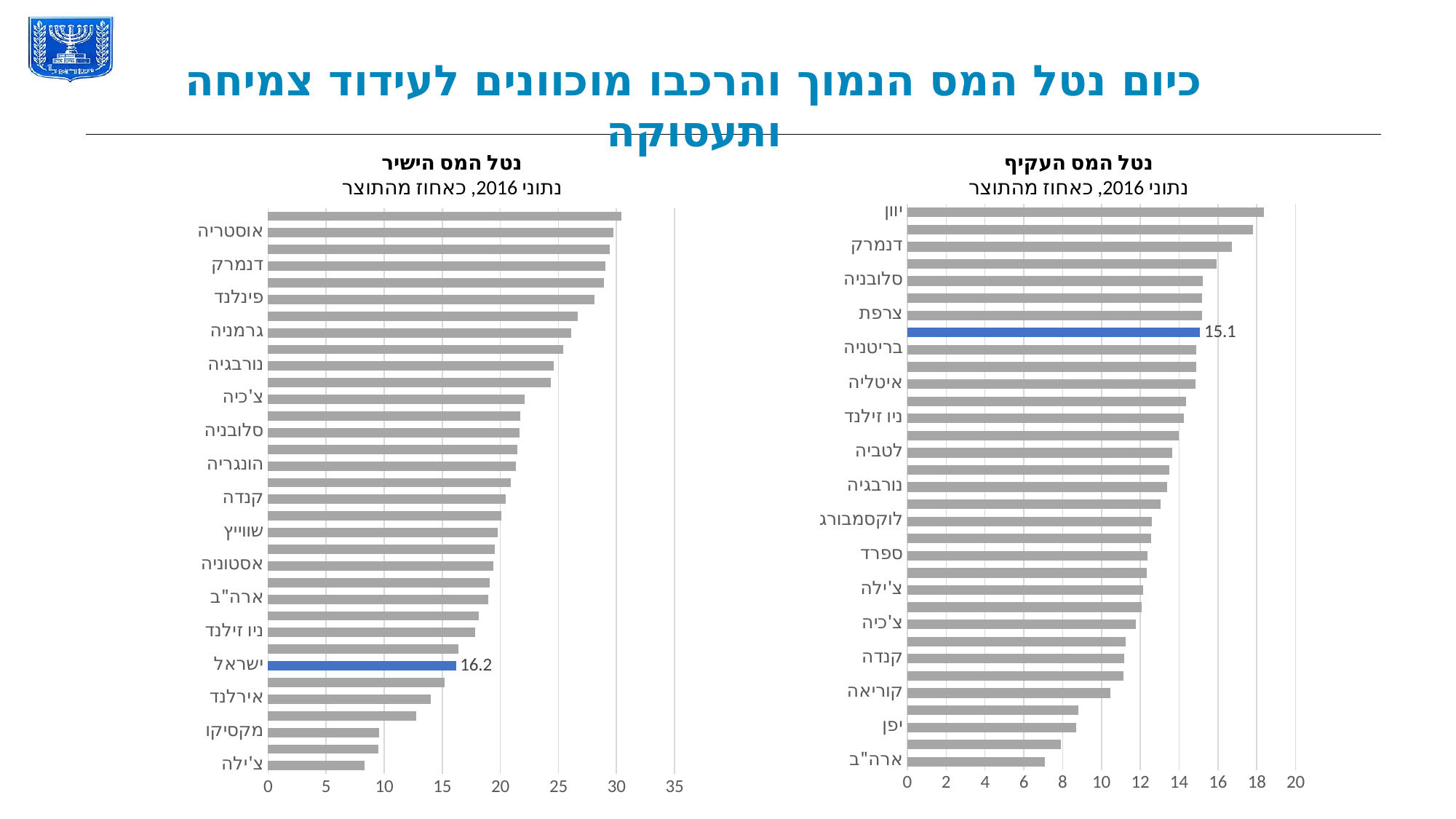
In the left chart (נטל המס הישיר), which country's bar is highlighted in blue? ישראל In the right chart (נטל המס העקיף), which has a larger value, יוון or יפן? יוון In the left chart (נטל המס הישיר), what is the value shown for ישראל? 16.2 In the right chart (נטל המס העקיף), what value is printed on the blue highlighted bar? 15.1 In the left chart (נטל המס הישיר), is the value for צ'ילה greater or less than 10? less In the right chart (נטל המס העקיף), is the value for ארה"ב greater or less than 8? less In the left chart (נטל המס הישיר), is the value for אוסטריה greater or less than 25? greater What kind of chart is used on this slide? Bar chart In the right chart (נטל המס העקיף), which country has the highest value? יוון In the left chart (נטל המס הישיר), which has a larger value, אוסטריה or צ'ילה? אוסטריה In the left chart (נטל המס הישיר), which country has the lowest value? צ'ילה